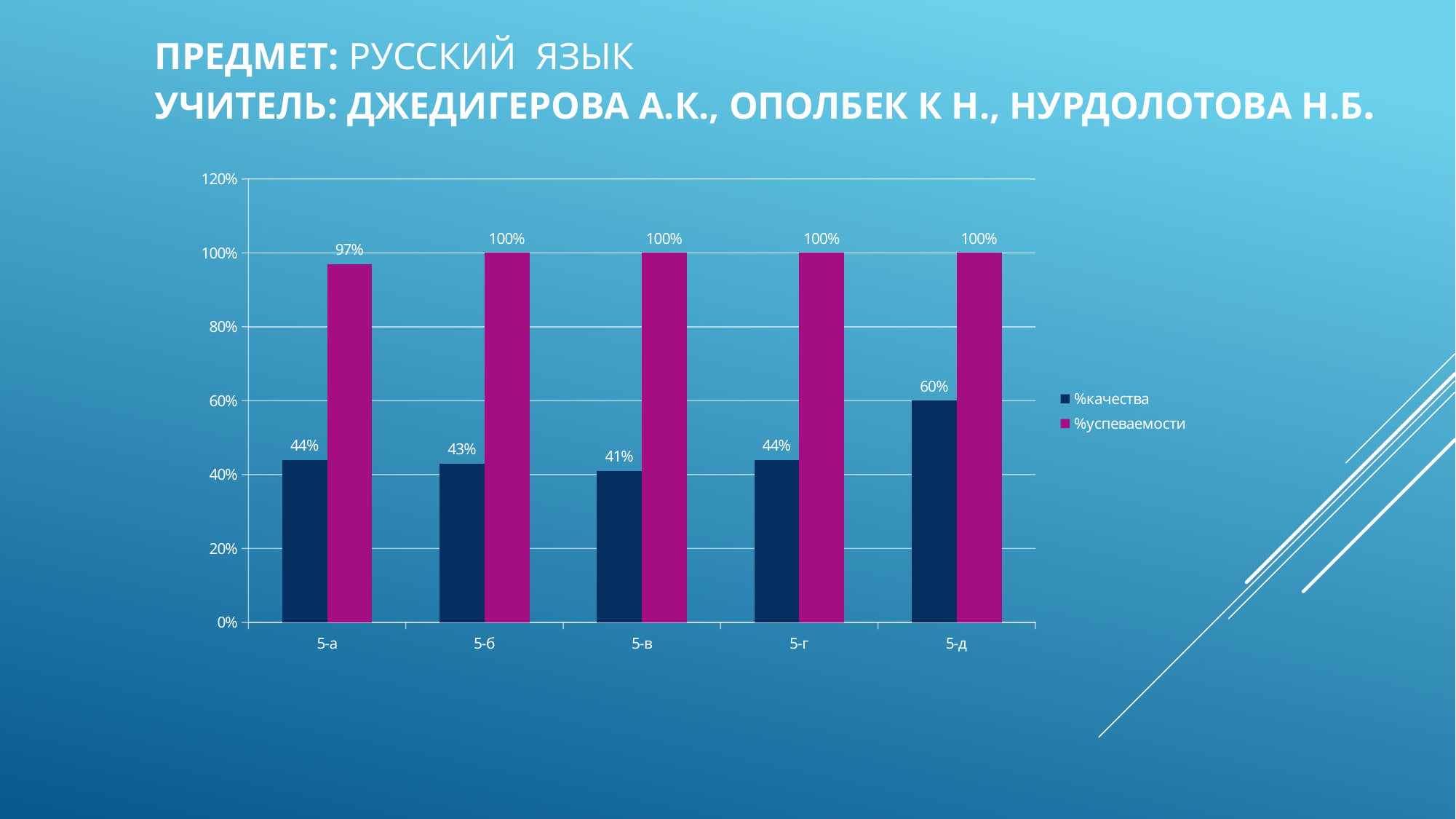
What kind of chart is shown on the slide? bar chart What is the difference between the %успеваемости and %качества values for 5-б? 57% Which colour represents %успеваемости in the legend? magenta How many series does the legend list? 2 Which class has the lowest %качества value? 5-в Which is larger, the %качества value for 5-д or for 5-а? 5-д Which class has the highest %качества value? 5-д What is the %качества value for 5-д? 60% What is the %успеваемости value for 5-а? 97% Which class has the lowest %успеваемости value? 5-а How many classes are shown on the x axis? 5 What is the %качества value for 5-в? 41%